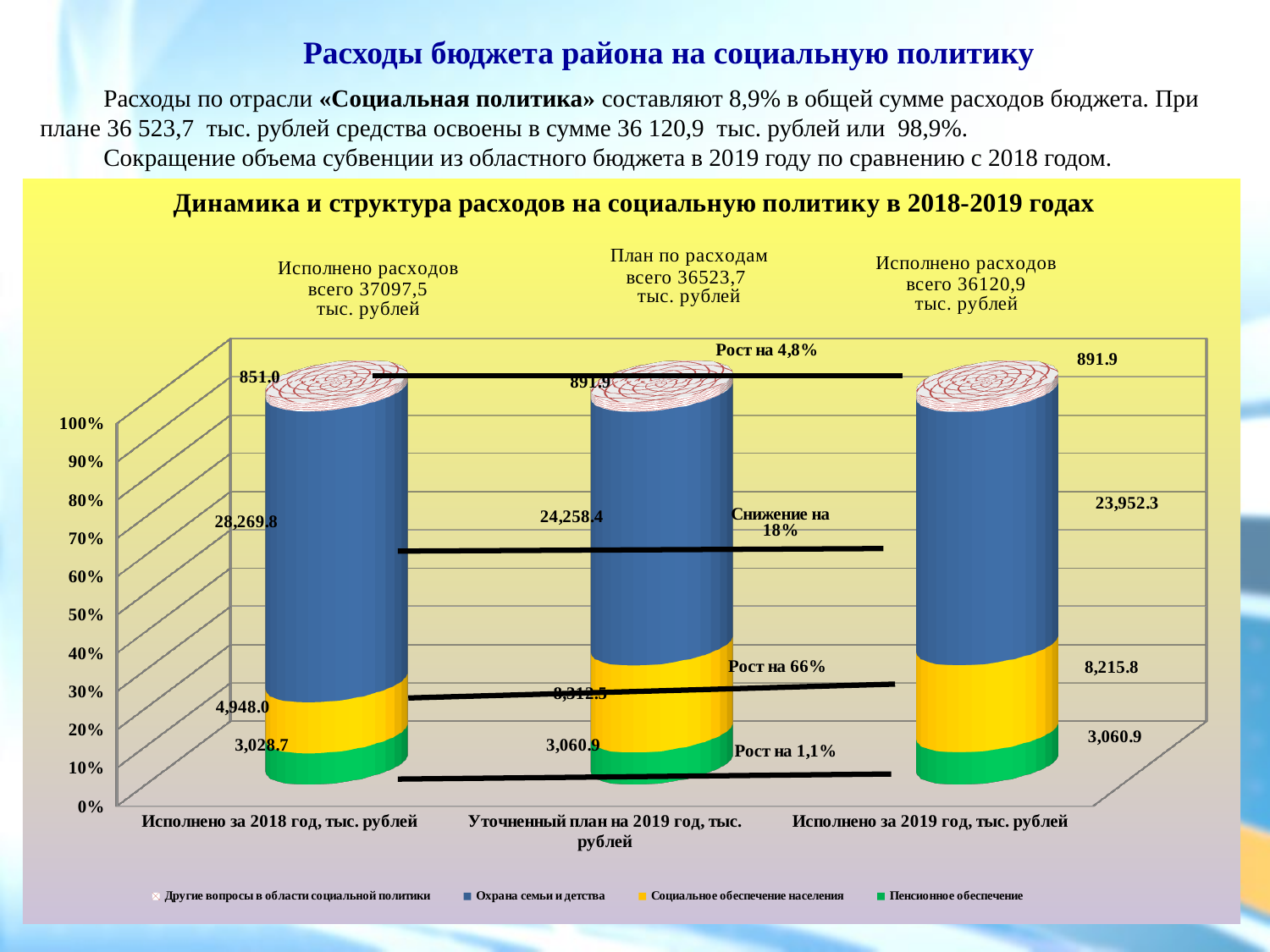
What is the title of the chart? Динамика и структура расходов на социальную политику в 2018-2019 годах What is the difference between the "Охрана семьи и детства" values for "Исполнено за 2018 год" and "Исполнено за 2019 год"? 4,317.5 What is the total of the "Исполнено за 2019 год" bar, as printed above the chart? 36120,9 тыс. рублей How many series does the chart legend list? 4 What is the value of "Социальное обеспечение населения" for "Исполнено за 2019 год, тыс. рублей"? 8,215.8 Which series has the highest value in the "Исполнено за 2019 год, тыс. рублей" bar? Охрана семьи и детства How many categories are shown along the x axis of the chart? 3 What kind of chart is shown on the slide? Stacked bar chart What is the value of "Охрана семьи и детства" for "Исполнено за 2018 год, тыс. рублей"? 28,269.8 Which is larger: "Социальное обеспечение населения" for "Исполнено за 2018 год" or for "Исполнено за 2019 год"? Исполнено за 2019 год What is the value of "Пенсионное обеспечение" for "Исполнено за 2018 год, тыс. рублей"? 3,028.7 What is the value of "Другие вопросы в области социальной политики" for "Исполнено за 2019 год, тыс. рублей"? 891.9